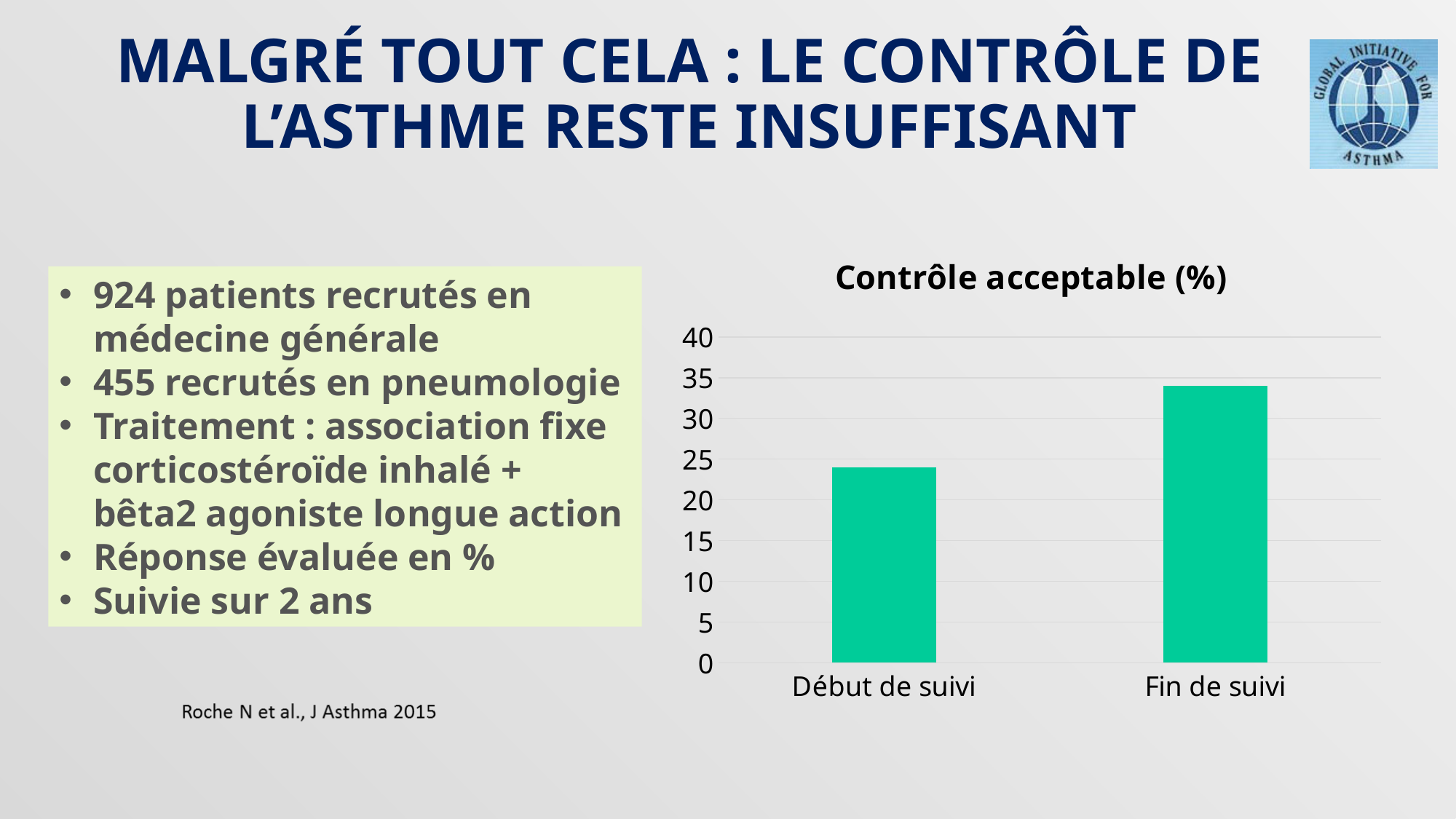
Which category has the highest value? Fin de suivi Is the value for Fin de suivi greater or less than 30? greater Do the values rise or fall from Début de suivi to Fin de suivi? rise Is the value for Début de suivi greater or less than 20? greater Is the value for Début de suivi greater or less than 25? less Which category has the lowest value? Début de suivi Which is larger, the value for Début de suivi or the value for Fin de suivi? Fin de suivi What kind of chart is shown on the slide? bar chart How many categories are plotted on the chart? 2 What is the highest value shown on the vertical axis of the chart? 40 What is the title of the chart? Contrôle acceptable (%)